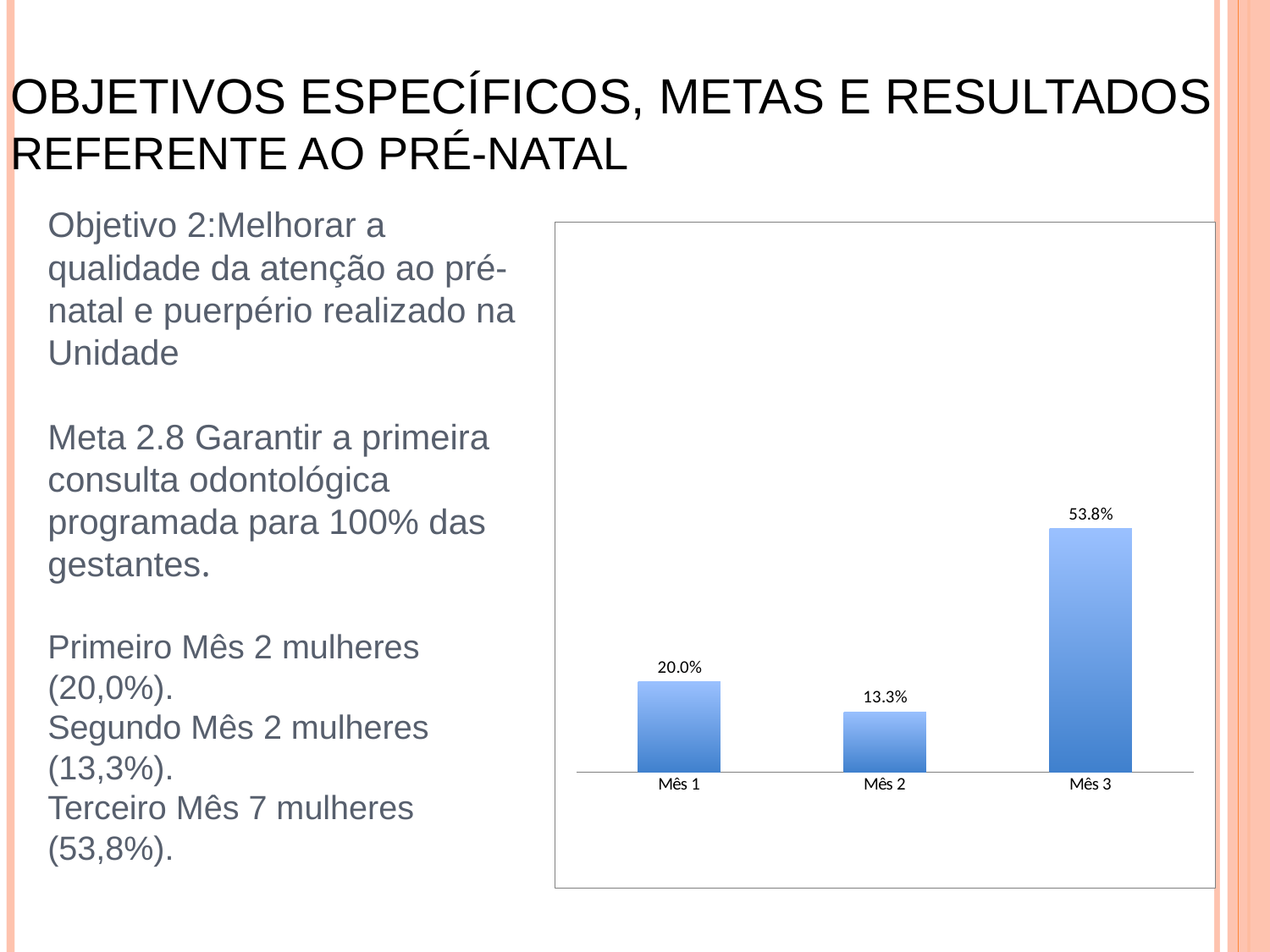
What colour are the bars in the chart? Blue What kind of chart is shown on the slide? Bar chart Which is larger, the value for Mês 1 or the value for Mês 2? Mês 1 How many categories are shown on the x axis? 3 Does the value rise or fall from Mês 2 to Mês 3? Rise What is the difference between the values for Mês 3 and Mês 1? 33.8% What is the difference between the values for Mês 1 and Mês 2? 6.7% Which category has the lowest value? Mês 2 What is the value for Mês 2? 13.3% What is the value for Mês 3? 53.8% What is the value for Mês 1? 20.0% Which category has the highest value? Mês 3